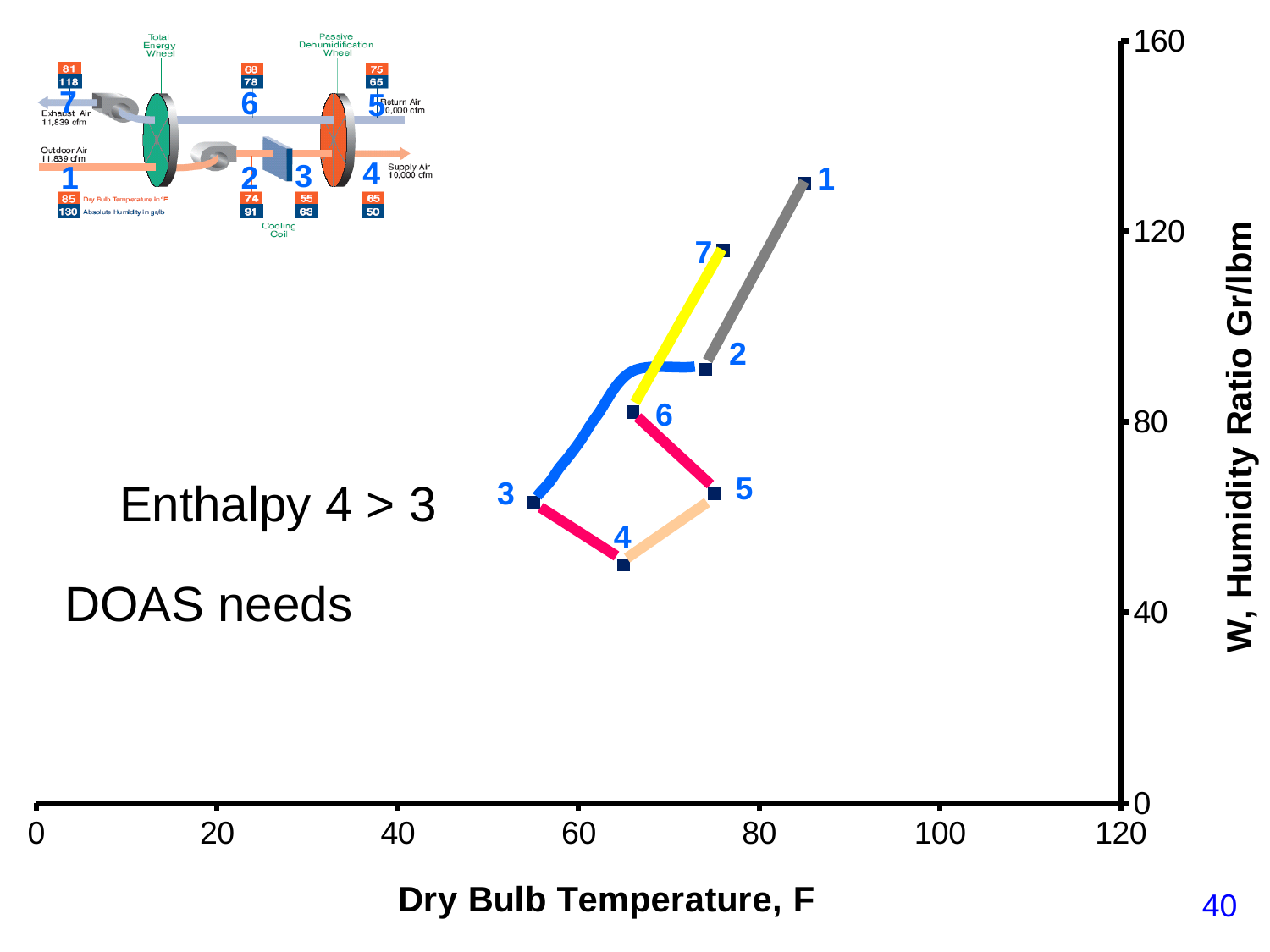
Which numbered point has the lowest humidity ratio on the chart? 4 Which numbered point has the highest humidity ratio on the chart? 1 Is the dry bulb temperature at point 3 greater or less than 60 F? less How many numbered state points are plotted on the chart? 7 Is the humidity ratio at point 7 greater or less than 120 Gr/lbm? less Which point has the higher dry bulb temperature, point 3 or point 4? 4 What is the title of the x axis of the chart? Dry Bulb Temperature, F Is the humidity ratio at point 1 greater or less than 120 Gr/lbm? greater What is the title of the y axis of the chart? W, Humidity Ratio Gr/lbm Which numbered point has the lowest dry bulb temperature on the chart? 3 What is the maximum value shown on the y axis of the chart? 160